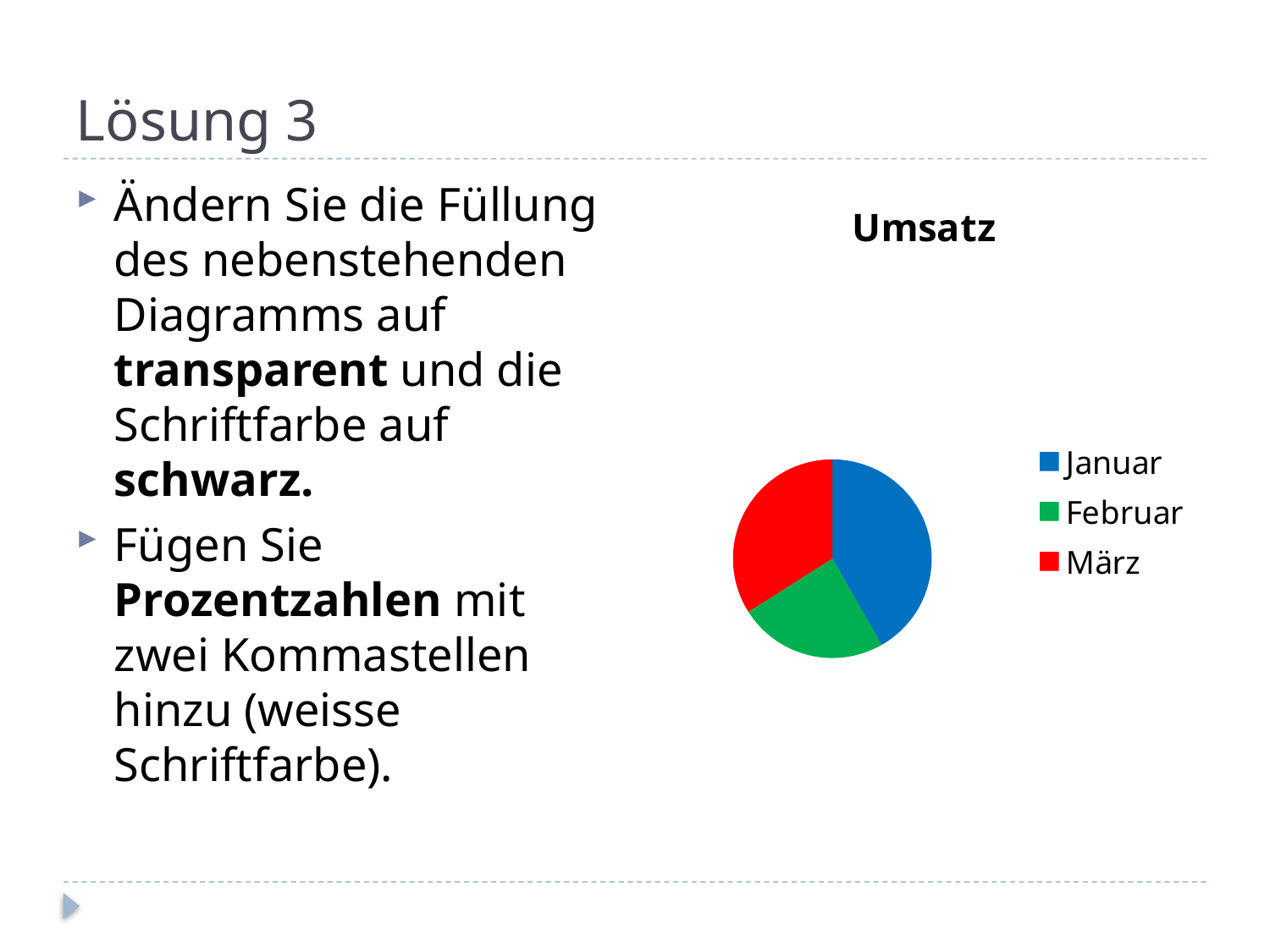
Which category has the smallest slice in the pie chart? Februar Which slice is larger in the pie chart, März or Februar? März Which slice is larger in the pie chart, Januar or Februar? Januar Which colour represents März in the pie chart? red What kind of chart is shown on the slide? pie chart Which category has the largest slice in the pie chart? Januar What is the title of the pie chart? Umsatz How many entries does the legend of the pie chart list? 3 How many slices does the pie chart have? 3